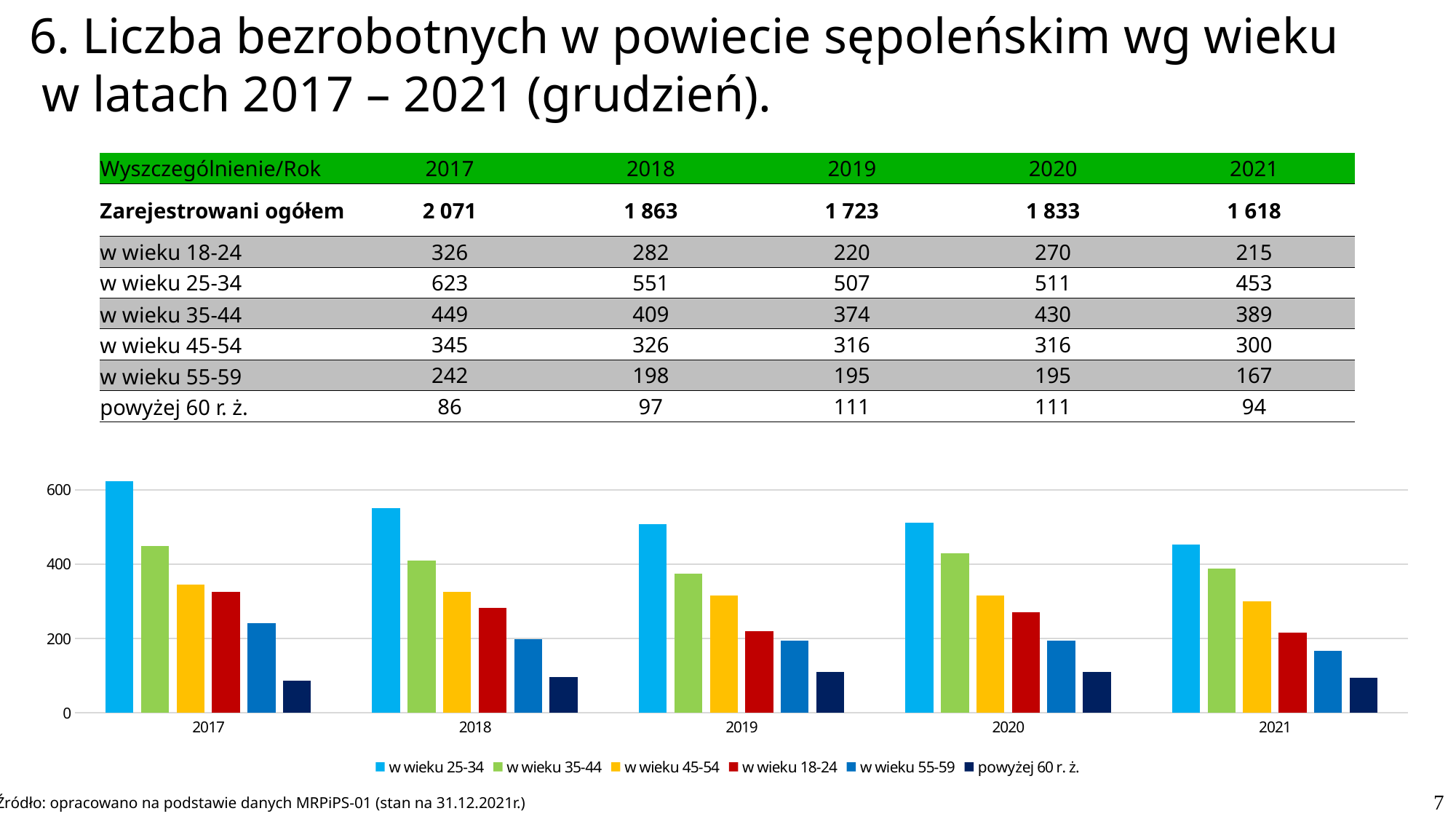
Which age group has the lowest value in 2019? powyżej 60 r. ż. What is the value for 'powyżej 60 r. ż.' in 2021? 94 What is the value for 'w wieku 35-44' in 2020? 430 Does the value for 'w wieku 25-34' rise or fall from 2017 to 2019? fall Which is larger in 2018: 'w wieku 45-54' or 'w wieku 18-24'? w wieku 45-54 Is the value for 'w wieku 55-59' in 2017 greater or less than 200? greater Which age group has the highest value in every year shown? w wieku 25-34 How many series does the chart legend list? 6 What is the value for 'w wieku 25-34' in 2017? 623 What kind of chart is shown on the slide? bar chart What is the difference between the 'w wieku 25-34' values in 2017 and 2021? 170 How many years are shown along the x axis of the chart? 5